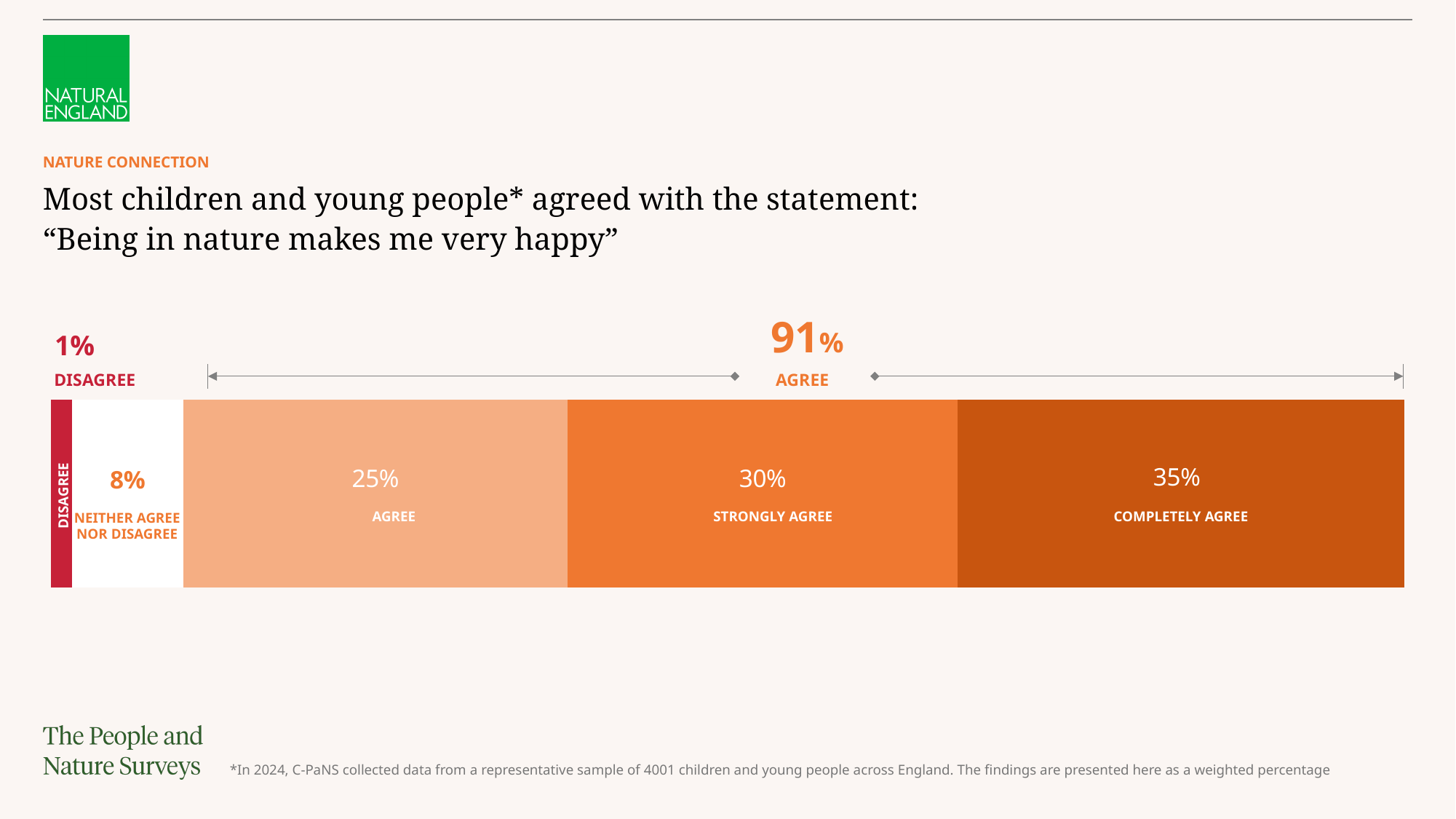
What is the difference in percentage points between 'Completely agree' and 'Agree'? 10 Which response category has the smallest share? Disagree What is the combined percentage of respondents who agreed with the statement, as shown above the bar? 91% Which is larger, the share for 'Strongly agree' or the share for 'Agree'? Strongly agree What percentage of children and young people said they 'Completely agree' that being in nature makes them very happy? 35% What percentage of respondents chose 'Neither agree nor disagree'? 8% Which response category has the largest share? Completely agree How many response categories are shown in the bar? 5 What is the total of the 'Agree', 'Strongly agree' and 'Completely agree' segments? 90% What percentage of respondents chose 'Strongly agree'? 30% What percentage of respondents disagreed with the statement? 1% What kind of chart is shown on the slide? Stacked bar chart